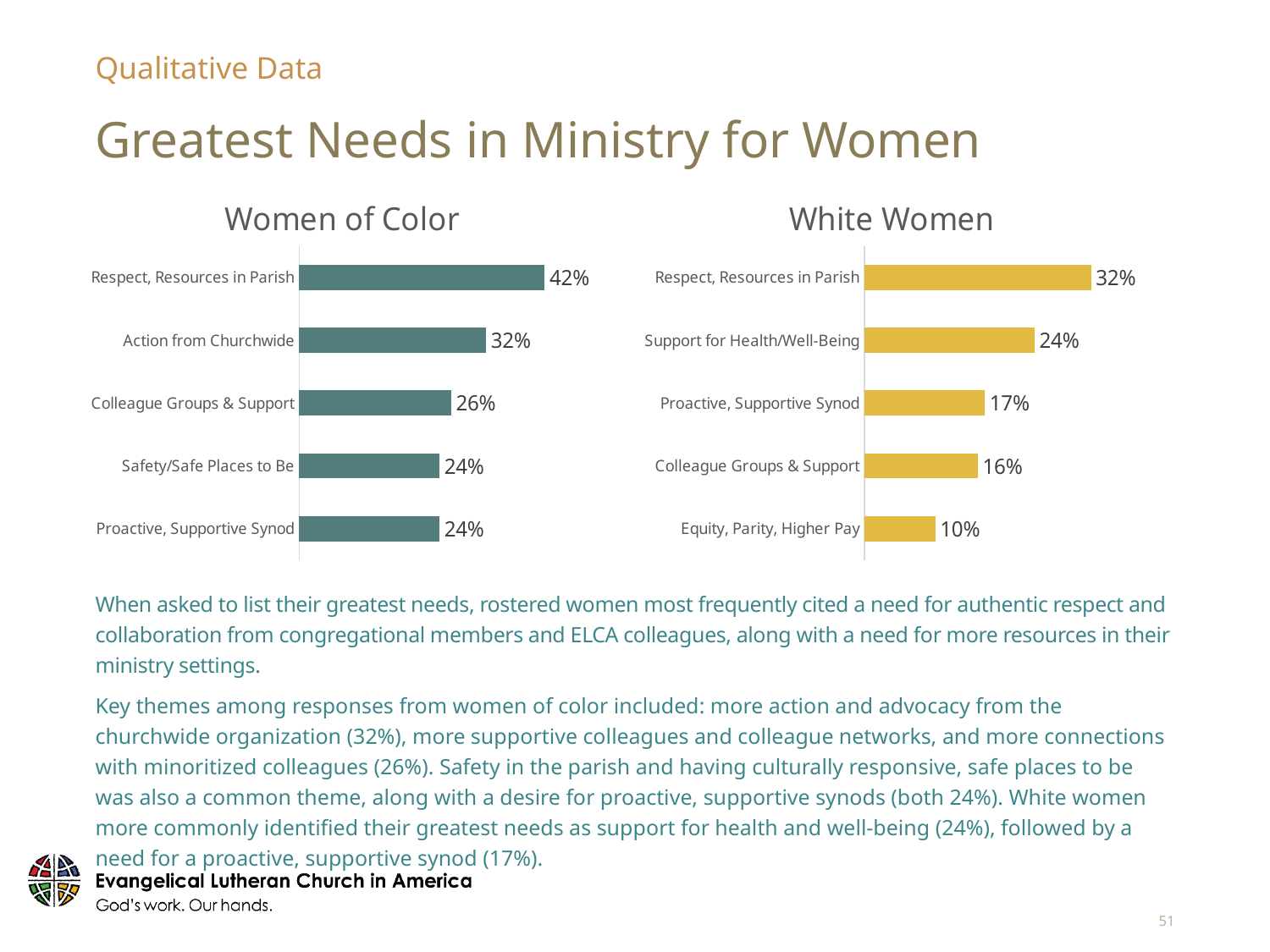
In the Women of Color chart, what is the value for Colleague Groups & Support? 26% What is the title of the chart on the right side of the slide? White Women How many categories are shown in the White Women chart? 5 Which is larger: Colleague Groups & Support in the Women of Color chart or Colleague Groups & Support in the White Women chart? Women of Color In the White Women chart, what is the value for Proactive, Supportive Synod? 17% What type of chart is the Women of Color chart? Bar chart In the White Women chart, what is the difference between Respect, Resources in Parish and Equity, Parity, Higher Pay? 22% In the Women of Color chart, what is the difference between Respect, Resources in Parish and Action from Churchwide? 10% In the Women of Color chart, which category has the highest value? Respect, Resources in Parish In the Women of Color chart, what is the value for Respect, Resources in Parish? 42% In the White Women chart, which category has the lowest value? Equity, Parity, Higher Pay In the White Women chart, what is the value for Support for Health/Well-Being? 24%